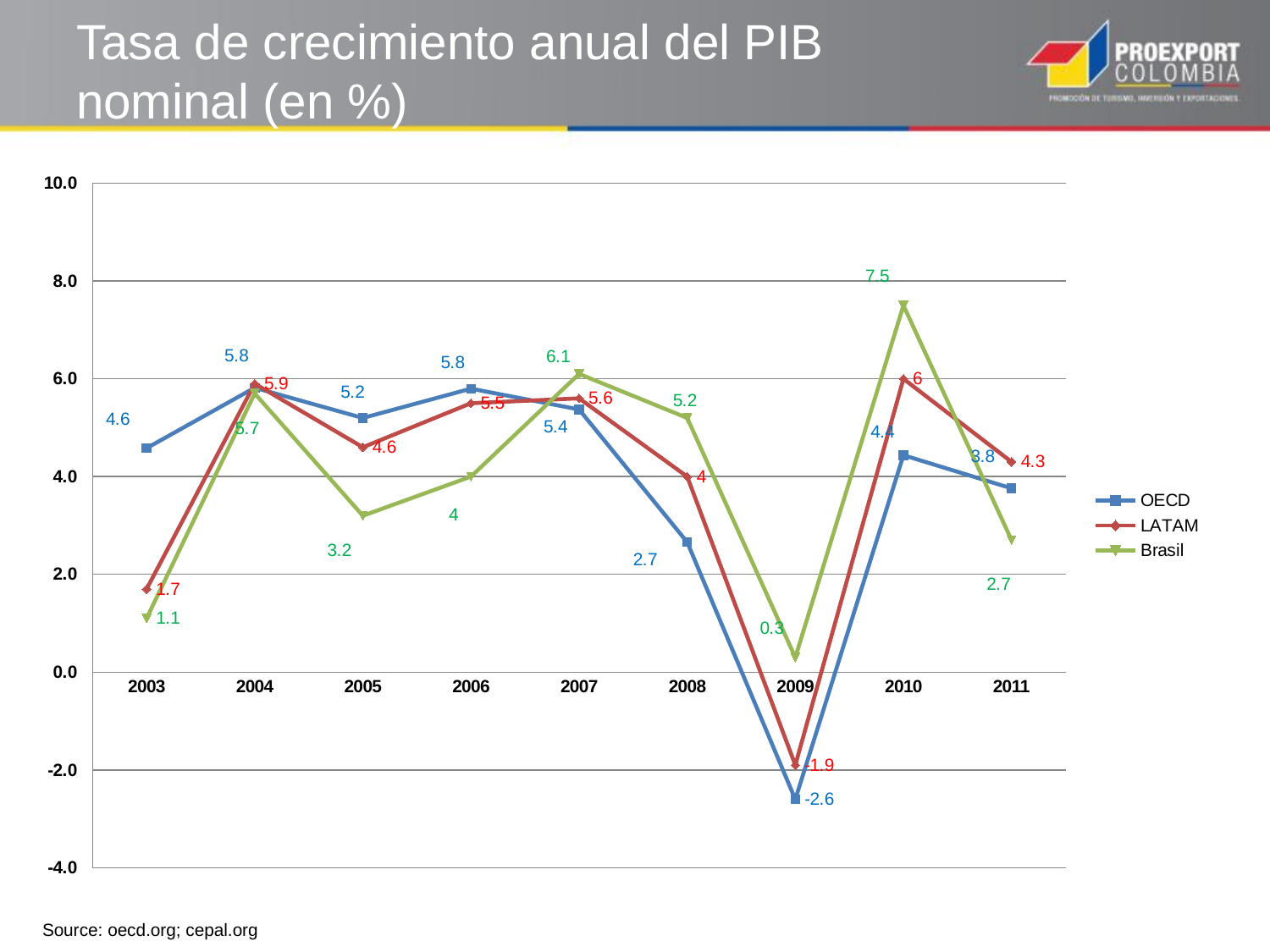
What type of chart is shown on the slide? line chart Does the OECD series rise or fall from 2007 to 2009? fall What is the value for LATAM in 2003? 1.7 How many series does the legend list? 3 In which year is the Brasil series at its highest? 2010 How many years are shown on the x axis? 9 What is the value for OECD in 2009? -2.6 In which year is the OECD series at its lowest? 2009 What is the value for Brasil in 2010? 7.5 What is the difference between the LATAM value in 2010 and the OECD value in 2010? 1.6 Which series is drawn in green? Brasil Which is larger in 2008, the value for Brasil or the value for OECD? Brasil